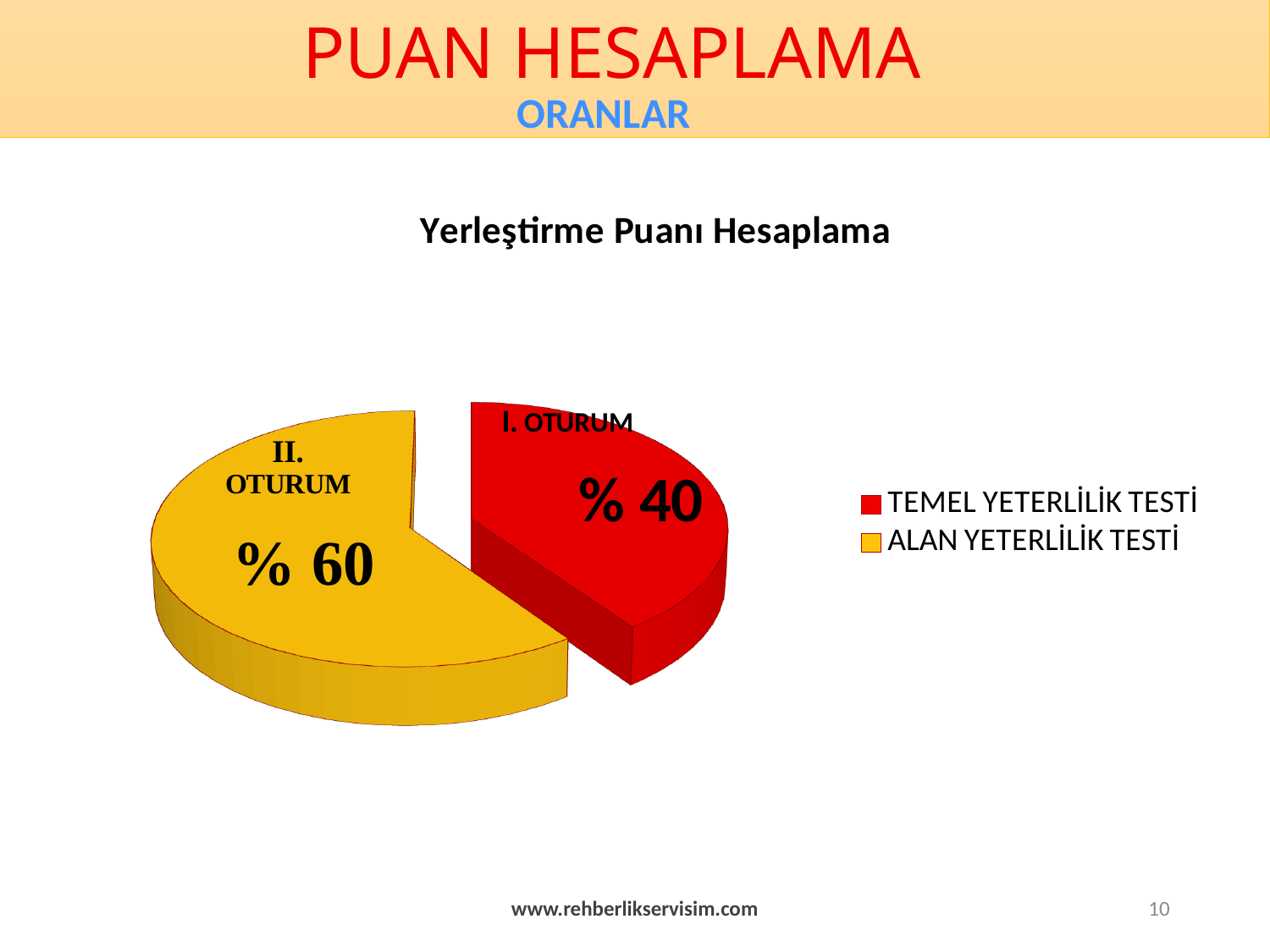
What colour is the TEMEL YETERLİLİK TESTİ slice? red What share of the pie does TEMEL YETERLİLİK TESTİ (I. OTURUM) have? % 40 What is the difference in percentage points between the ALAN YETERLİLİK TESTİ slice and the TEMEL YETERLİLİK TESTİ slice? 20 Which is larger, the share for TEMEL YETERLİLİK TESTİ or the share for ALAN YETERLİLİK TESTİ? ALAN YETERLİLİK TESTİ How many entries does the legend list? 2 What is the chart's title? Yerleştirme Puanı Hesaplama Which session label (oturum) is shown on the yellow slice? II. OTURUM What share of the pie does ALAN YETERLİLİK TESTİ (II. OTURUM) have? % 60 How many slices does the pie chart have? 2 Which slice is the smallest in the pie chart? TEMEL YETERLİLİK TESTİ Which slice is the largest in the pie chart? ALAN YETERLİLİK TESTİ What kind of chart is shown on the slide? pie chart